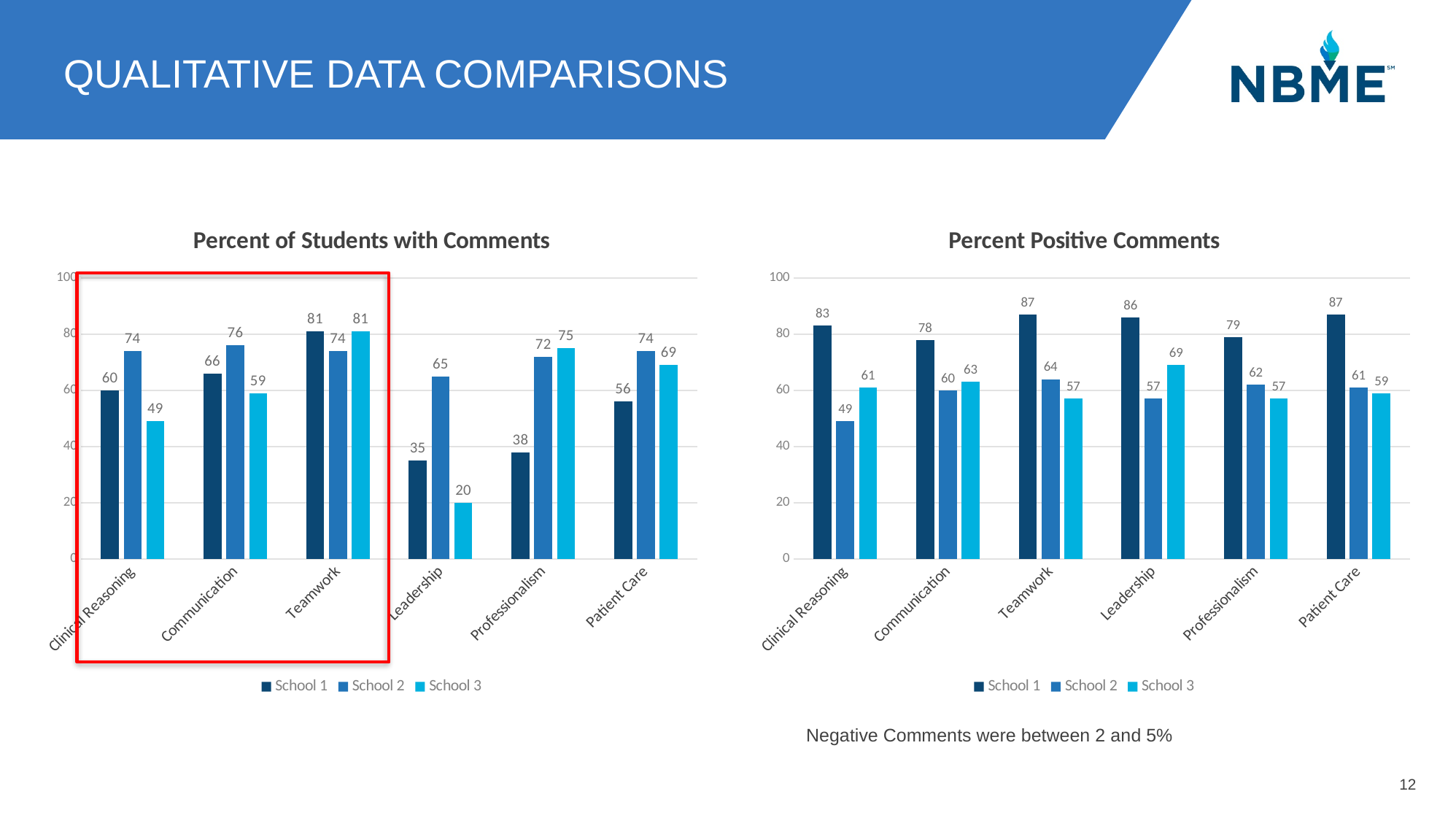
In the 'Percent of Students with Comments' chart, what is the value for School 3 in Leadership? 20 In the 'Percent of Students with Comments' chart, what is the difference between School 2 and School 3 in Leadership? 45 How many categories are shown on the x axis of the 'Percent of Students with Comments' chart? 6 In the 'Percent Positive Comments' chart, what is the difference between School 1 and School 2 in Teamwork? 23 How many series does the legend of the 'Percent Positive Comments' chart list? 3 What type of chart is the 'Percent Positive Comments' chart? Bar chart In the 'Percent of Students with Comments' chart, what is the value for School 2 in Communication? 76 In the 'Percent of Students with Comments' chart, which category has the lowest value for School 1? Leadership In the 'Percent Positive Comments' chart, what is the value for School 1 in Clinical Reasoning? 83 In the 'Percent Positive Comments' chart, what is the value for School 3 in Leadership? 69 In the 'Percent Positive Comments' chart, which category has the lowest value for School 2? Clinical Reasoning In the 'Percent of Students with Comments' chart, which is larger for Professionalism: School 1 or School 3? School 3